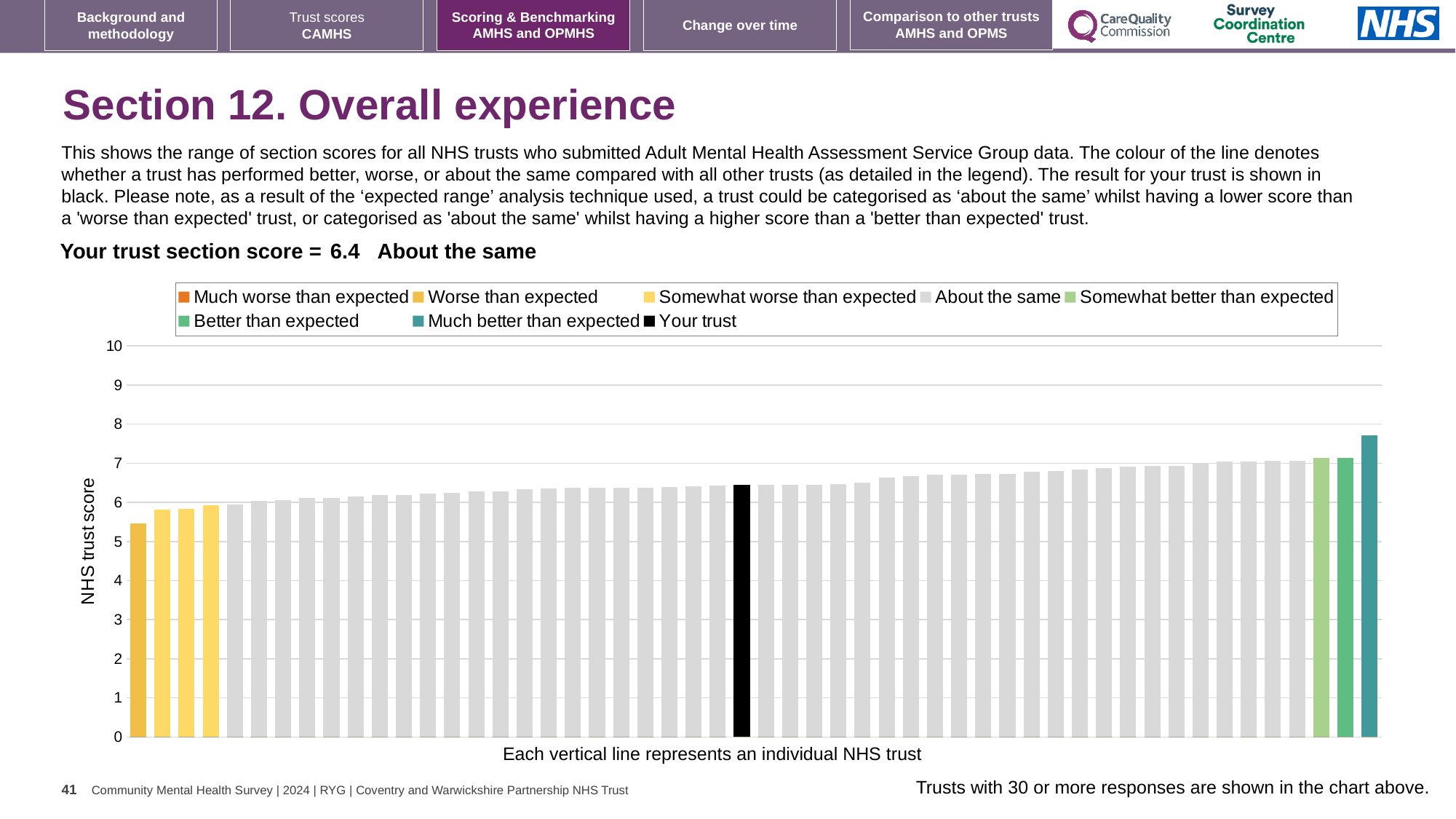
Is the value of the shortest bar on the far left greater or less than 6? less How many bars are coloured light green for 'Somewhat better than expected'? 1 What colour is the bar representing your trust? black Is the value of the black 'Your trust' bar greater or less than 5? greater Which category is your trust's section score placed in? About the same What is the section score for your trust? 6.4 What kind of chart is shown on the slide? bar chart What is the title of the vertical axis? NHS trust score Do the bar values rise or fall from left to right across the chart? rise How many entries does the chart legend list? 8 How many bars are coloured teal for 'Much better than expected'? 1 Is the value of the tallest bar (the teal 'Much better than expected' trust) greater or less than 7? greater